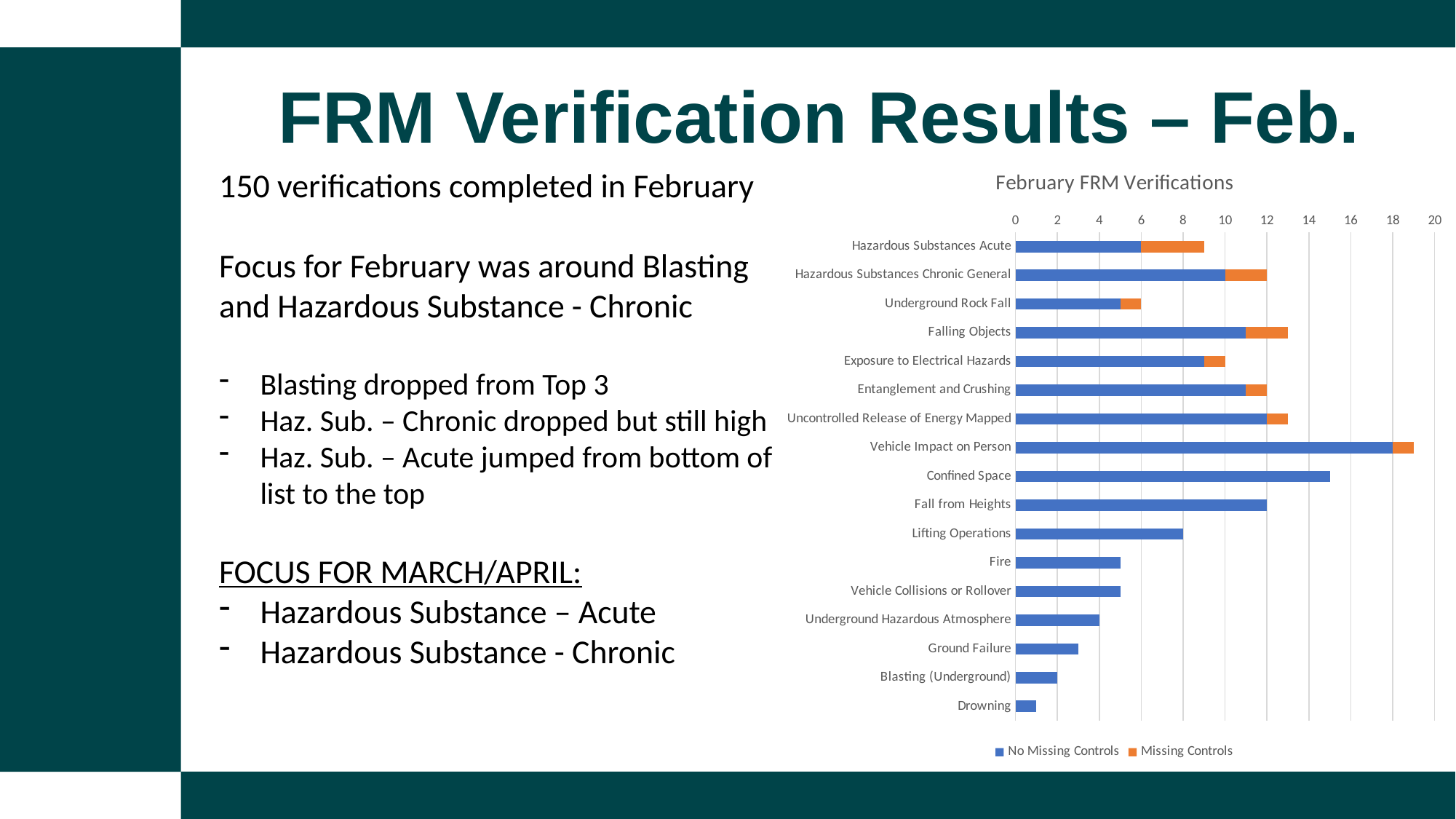
What is the title of the chart? February FRM Verifications What kind of chart is shown on the slide? bar chart Which series is shown in orange in the chart? Missing Controls Is the total bar for Vehicle Impact on Person greater or less than 16? greater Which category has the longest bar in the chart? Vehicle Impact on Person Is the value for Ground Failure greater or less than 4? less How many categories are plotted in the chart? 17 Is the value for Drowning greater or less than 2? less Which category has the shortest bar in the chart? Drowning Which has a longer bar, Confined Space or Fall from Heights? Confined Space How many series does the chart legend list? 2